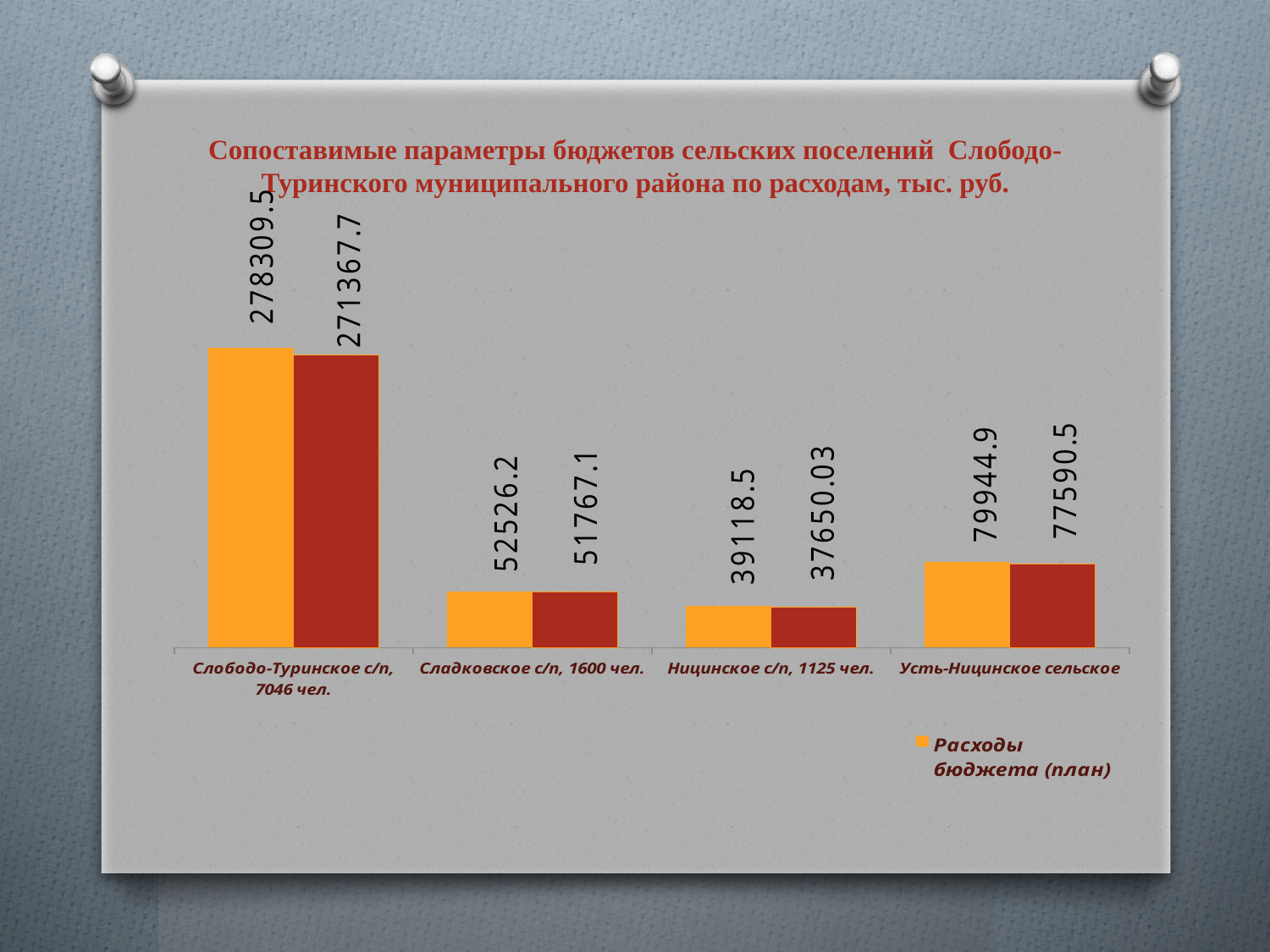
Which settlement has the highest planned budget expenditure? Слободо-Туринское с/п, 7046 чел. What kind of chart is shown on the slide? Bar chart What value is shown on the red bar for Ницинское с/п, 1125 чел.? 37650.03 Which settlement has the lowest planned budget expenditure? Ницинское с/п, 1125 чел. Which is larger: the planned budget expenditure for Сладковское с/п, 1600 чел. or for Усть-Ницинское сельское? Усть-Ницинское сельское What is the planned budget expenditure (Расходы бюджета (план)) for Слободо-Туринское с/п, 7046 чел.? 278309.5 What is the planned budget expenditure (orange bar) for Усть-Ницинское сельское? 79944.9 How many settlements (categories) are shown on the chart? 4 What value is shown on the red bar for Сладковское с/п, 1600 чел.? 51767.1 What is the difference between the orange and red bars for Слободо-Туринское с/п, 7046 чел.? 6941.8 What is the difference between the orange and red bars for Усть-Ницинское сельское? 2354.4 What is the only series name listed in the chart legend? Расходы бюджета (план)